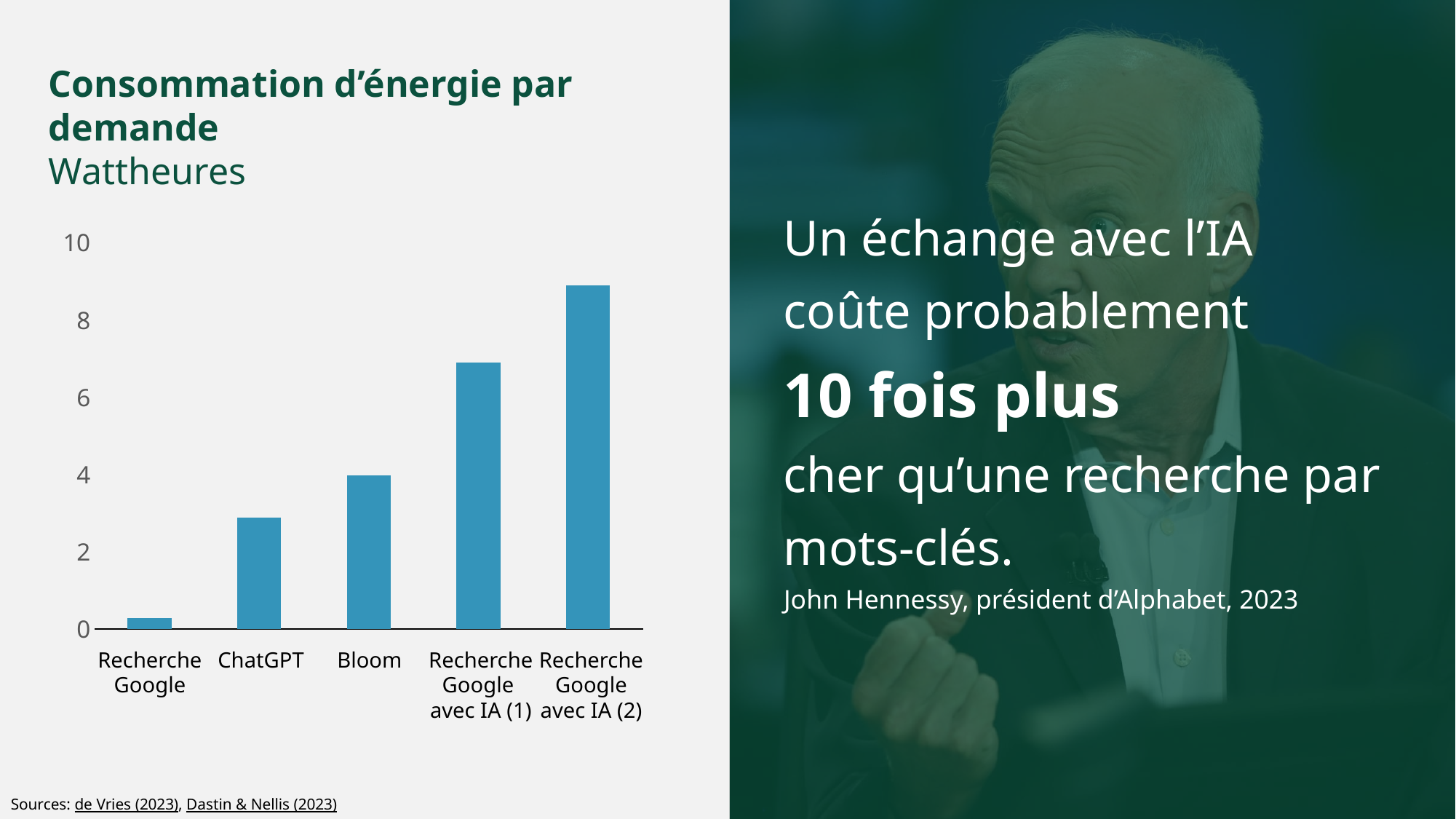
Which has a higher value, ChatGPT or Bloom? Bloom Is the value for ChatGPT greater or less than 4? less In what unit are the chart values expressed? Wattheures Which category has the highest energy consumption per request? Recherche Google avec IA (2) What kind of chart is shown on the slide? bar chart Which category has the lowest energy consumption per request? Recherche Google Is the value for Recherche Google greater or less than 2? less What is the title of the chart? Consommation d'énergie par demande Do the values rise or fall from left to right along the x axis? rise Is the value for Recherche Google avec IA (1) greater or less than 6? greater How many categories are shown on the x axis of the chart? 5